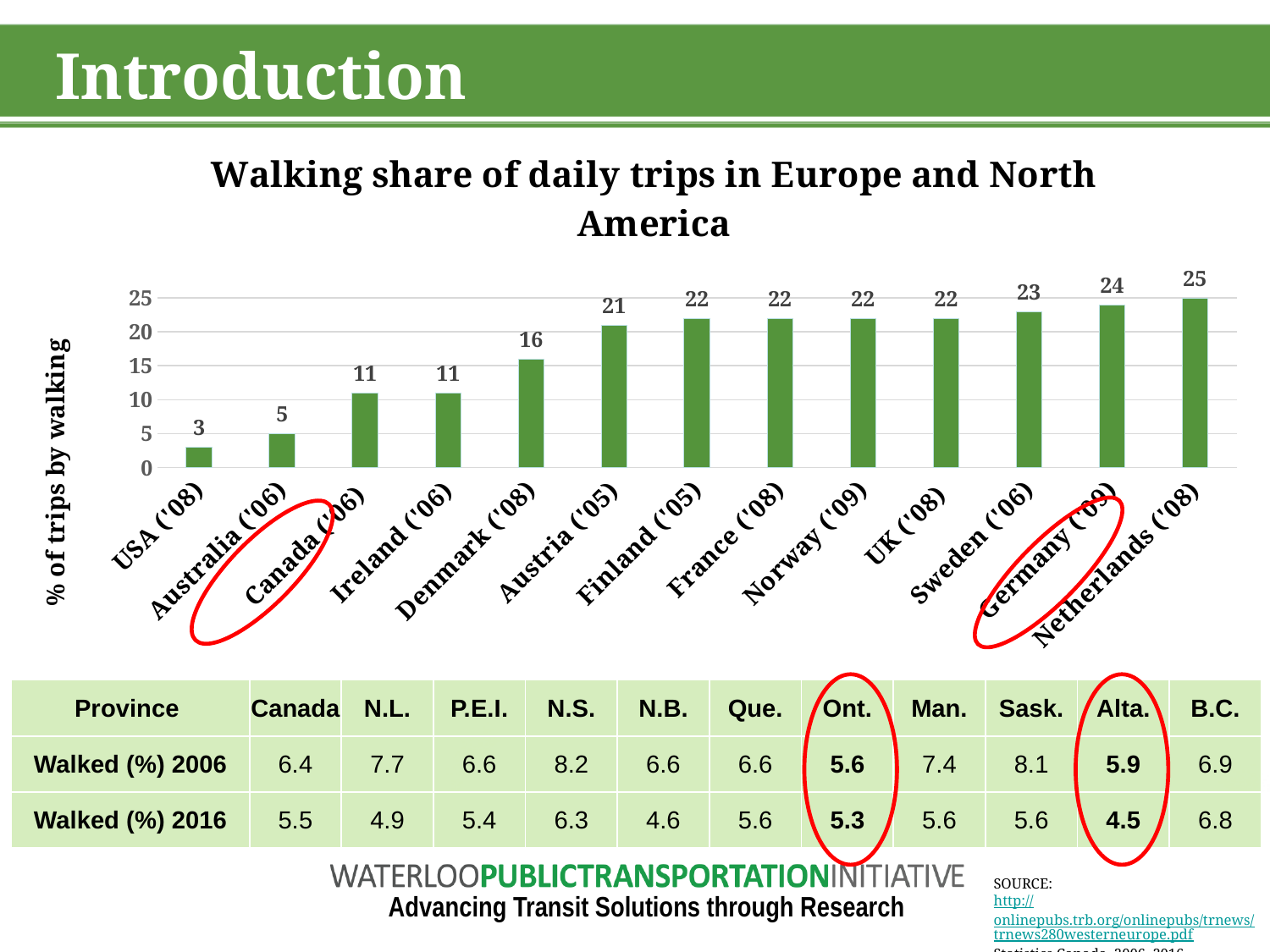
What is the walking share of daily trips for Germany ('09)? 24 What is the difference in walking share between Germany ('09) and Canada ('06)? 13 What type of chart is used to show the walking share of daily trips? Bar chart How many countries are shown in the bar chart? 13 Which country has the lowest walking share of daily trips in the chart? USA ('08) Which country has the highest walking share of daily trips in the chart? Netherlands ('08) Is the walking share for Austria ('05) greater or less than 20? greater Which has a larger walking share of daily trips, Australia ('06) or Denmark ('08)? Denmark ('08) What is the difference in walking share between Netherlands ('08) and USA ('08)? 22 What is the walking share of daily trips for Denmark ('08)? 16 What is the label of the vertical axis of the chart? % of trips by walking What is the walking share of daily trips for Canada ('06)? 11